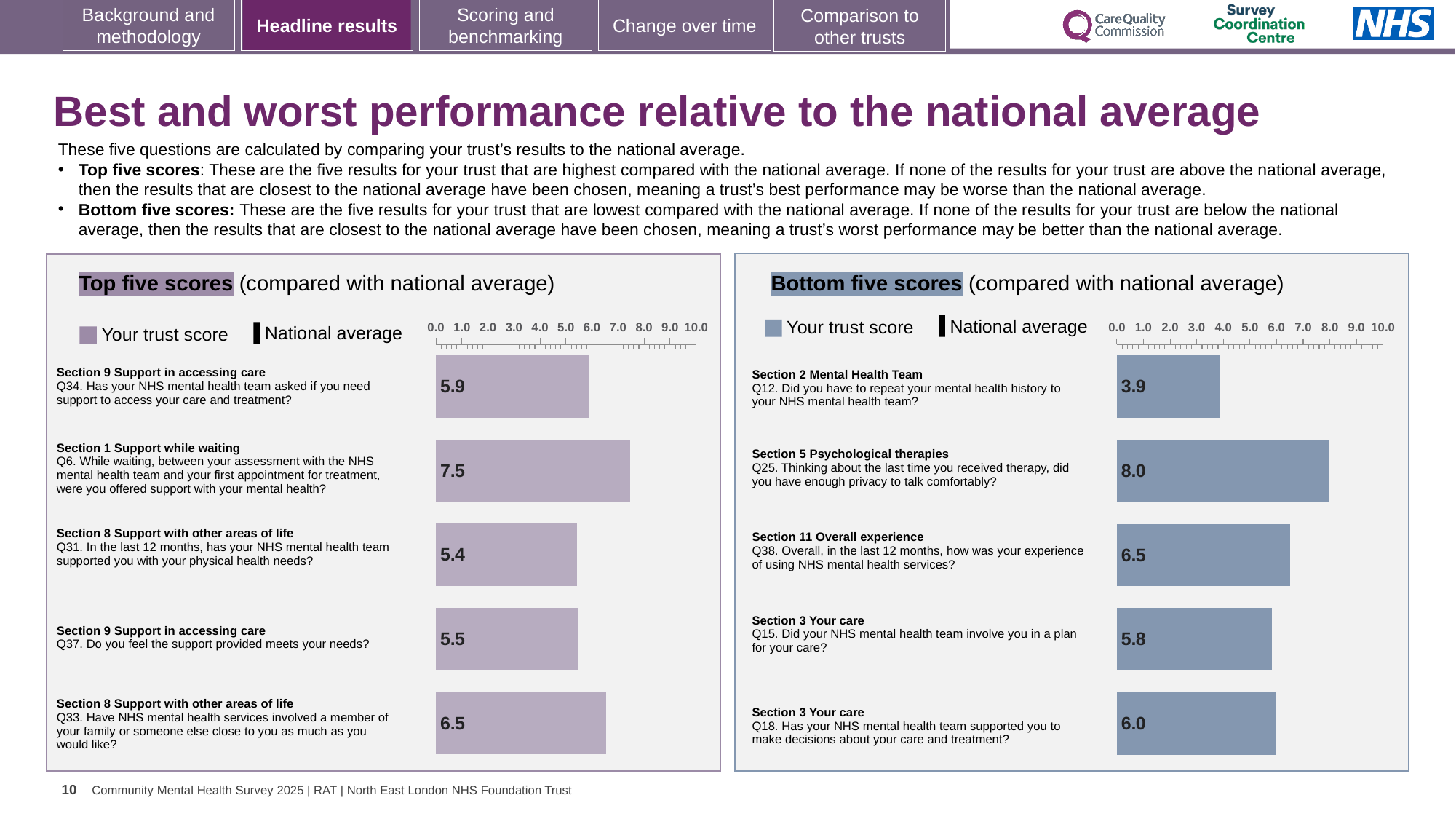
In the 'Top five scores' chart, what is the trust score for Q33 (involving family or someone close)? 6.5 In the 'Top five scores' chart, what is the trust score for Q6 (support while waiting)? 7.5 How many series does the legend of the 'Bottom five scores' chart list? 2 In the 'Top five scores' chart, which question has the lowest trust score? Q31 In the 'Bottom five scores' chart, which question has the lowest trust score? Q12 How many questions are shown in the 'Bottom five scores' chart? 5 In the 'Top five scores' chart, which question has the highest trust score? Q6 In the 'Bottom five scores' chart, what is the difference between the trust scores for Q25 and Q12? 4.1 In the 'Bottom five scores' chart, what is the trust score for Q25 (privacy during therapy)? 8.0 In the 'Bottom five scores' chart, what is the trust score for Q12 (repeating mental health history)? 3.9 What kind of chart is used in the 'Top five scores' panel? Bar chart In the 'Top five scores' chart, which has the larger trust score, Q34 or Q37? Q34